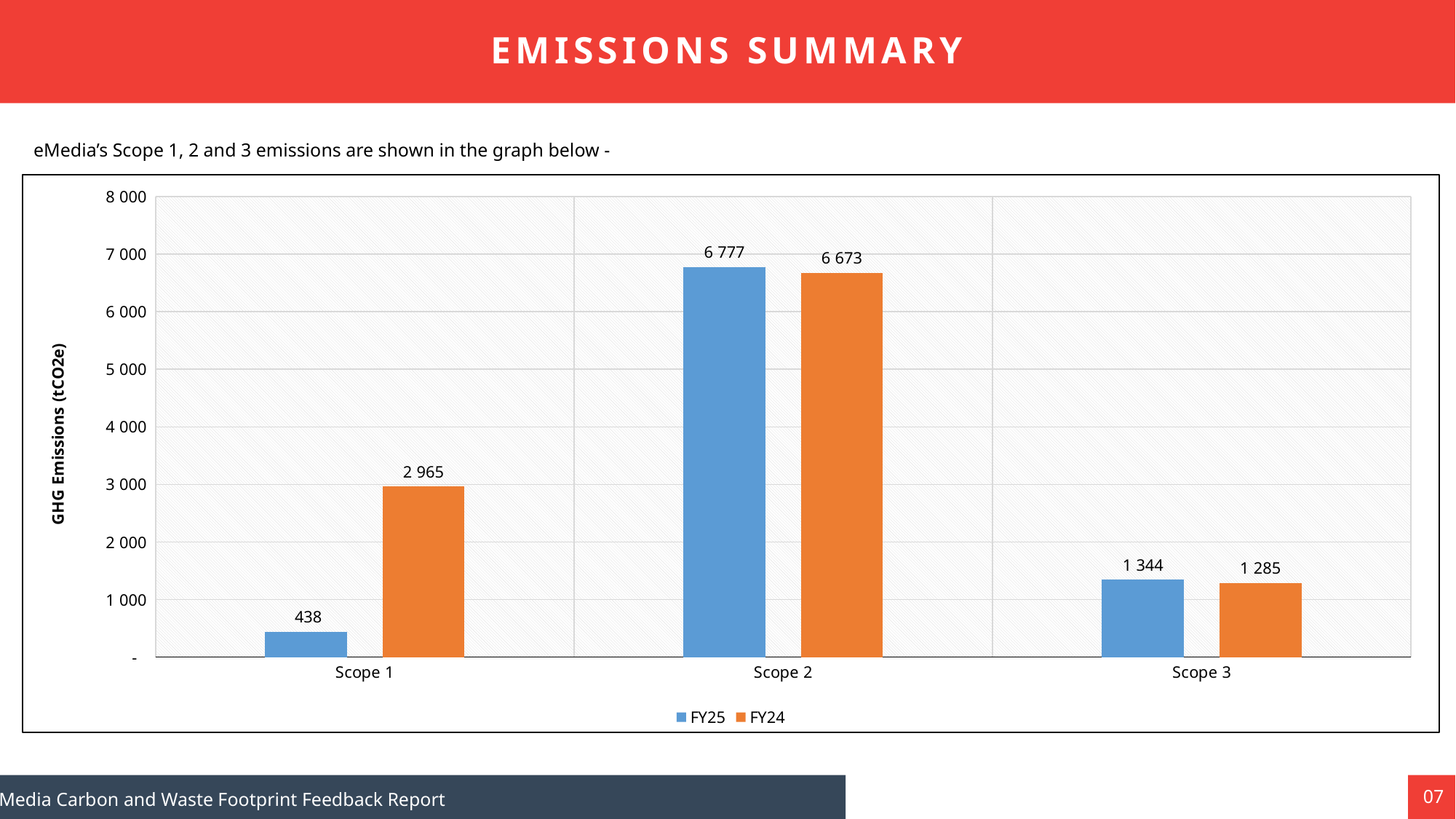
What is the FY24 value for Scope 2? 6 673 What kind of chart is shown on the slide? Bar chart What is the FY25 value for Scope 1? 438 Is the FY24 value for Scope 1 greater or less than 2 000? greater What is the FY25 value for Scope 3? 1 344 How many series does the legend list? 2 Which is larger for Scope 3, the FY25 value or the FY24 value? FY25 What is the label of the vertical axis? GHG Emissions (tCO2e) Which scope has the highest FY25 emissions? Scope 2 How many scope categories are shown on the x axis? 3 Which scope has the lowest FY24 emissions? Scope 3 What is the difference between the FY24 and FY25 values for Scope 1? 2 527